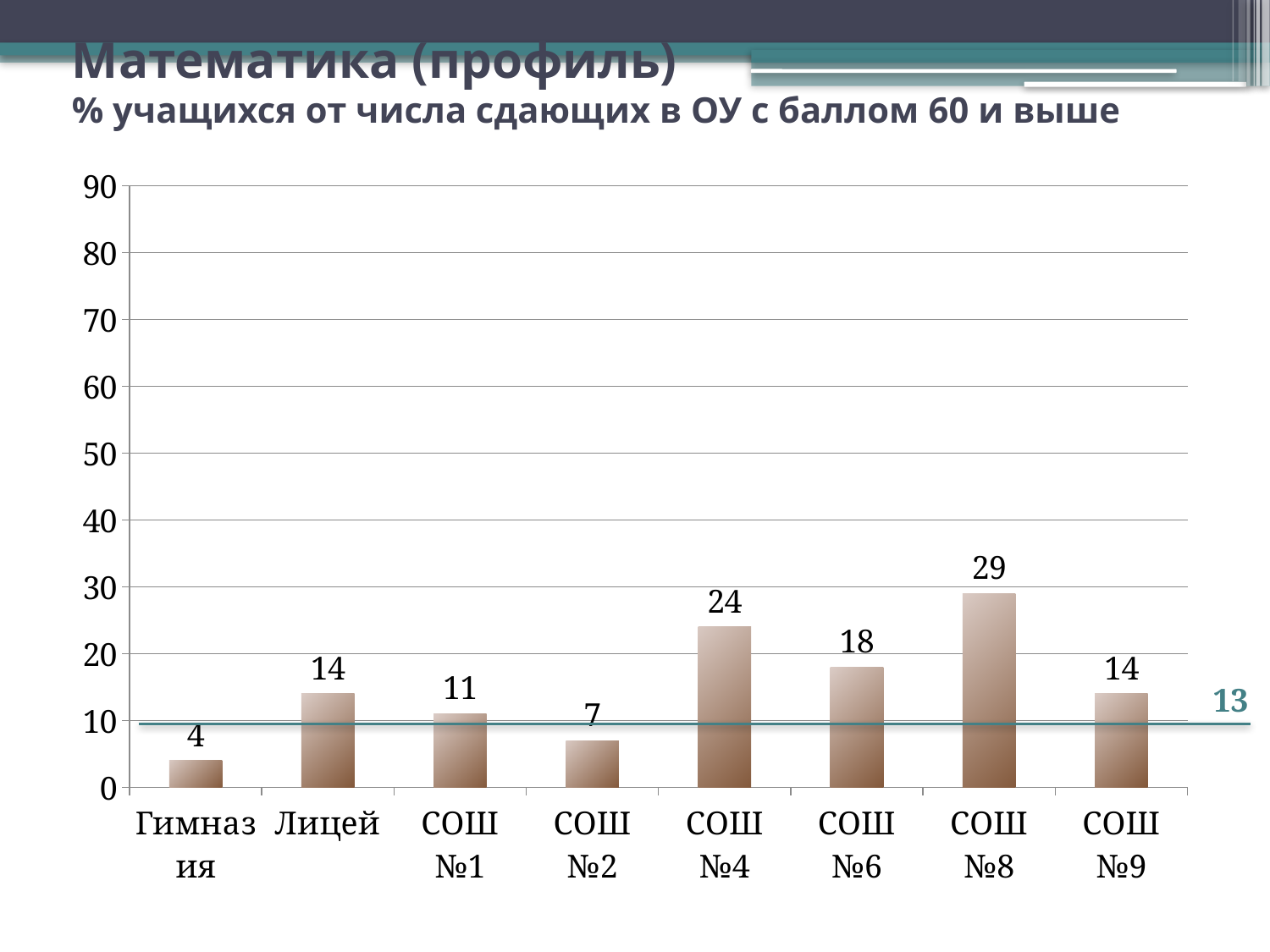
Which category has the highest value? СОШ №8 Is the value for СОШ №4 greater or less than 20? greater What is the value for СОШ №4? 24 What is the value for СОШ №6? 18 Which category has the lowest value? Гимназия What kind of chart is shown on the slide? bar chart Which is larger, the value for Лицей or the value for СОШ №1? Лицей What is the value for Гимназия? 4 What is the subtitle of the chart below 'Математика (профиль)'? % учащихся от числа сдающих в ОУ с баллом 60 и выше What value is labelled on the horizontal line drawn across the chart? 13 How many categories are shown on the x axis? 8 What is the difference between the values for СОШ №8 and СОШ №2? 22